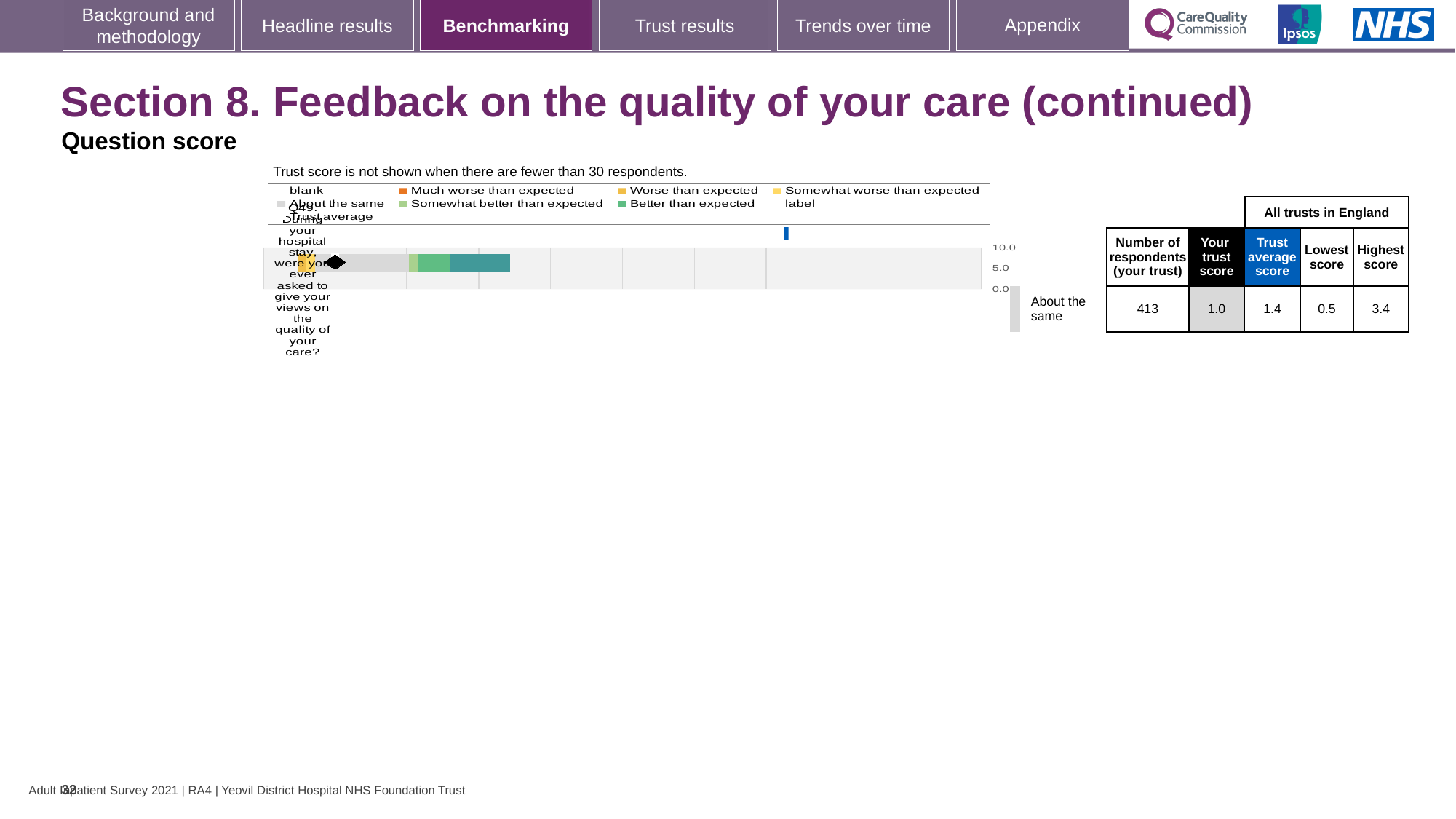
What is the lowest score among all trusts in England for Q49? 0.5 How many respondents from the trust answered Q49? 413 How many questions are plotted on the chart? 1 What is the difference between the highest score and the lowest score for Q49 across all trusts in England? 2.9 What is the maximum value shown on the chart's score axis? 10.0 What is the highest score among all trusts in England for Q49? 3.4 Which is larger for Q49: your trust score or the trust average score? Trust average score What is the trust average score for Q49 across all trusts in England? 1.4 What is the difference between the trust average score and your trust score for Q49? 0.4 What is the trust score for Q49 shown in the table next to the chart? 1.0 What benchmark category is the trust's Q49 result labelled as? About the same What kind of chart is used to show the Q49 benchmarking result? Bar chart